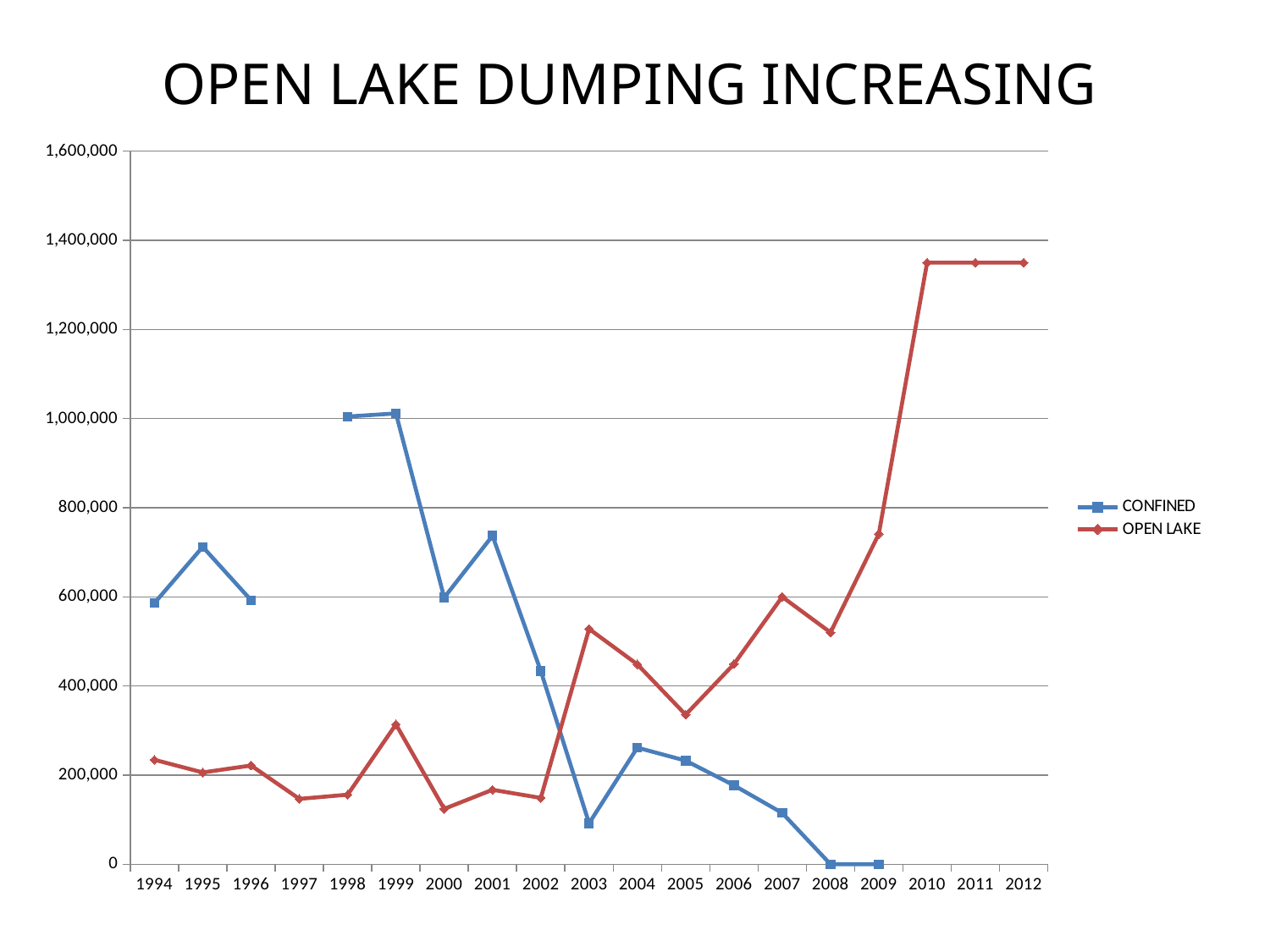
How many years are shown on the x axis? 19 How many series does the legend list? 2 Is the OPEN LAKE value for 2010 greater or less than 1,200,000? greater Does the CONFINED series rise or fall from 2004 to 2009? Fall Does the OPEN LAKE series rise or fall from 2009 to 2012? Rise What kind of chart is shown on the slide? Line chart What is the title of the chart? OPEN LAKE DUMPING INCREASING Is the CONFINED value for 1995 greater or less than 600,000? greater Is the OPEN LAKE value for 1997 greater or less than 200,000? less What is the CONFINED value in 2008? 0 Which is larger in 2012: the OPEN LAKE value or the CONFINED value in 1999? OPEN LAKE in 2012